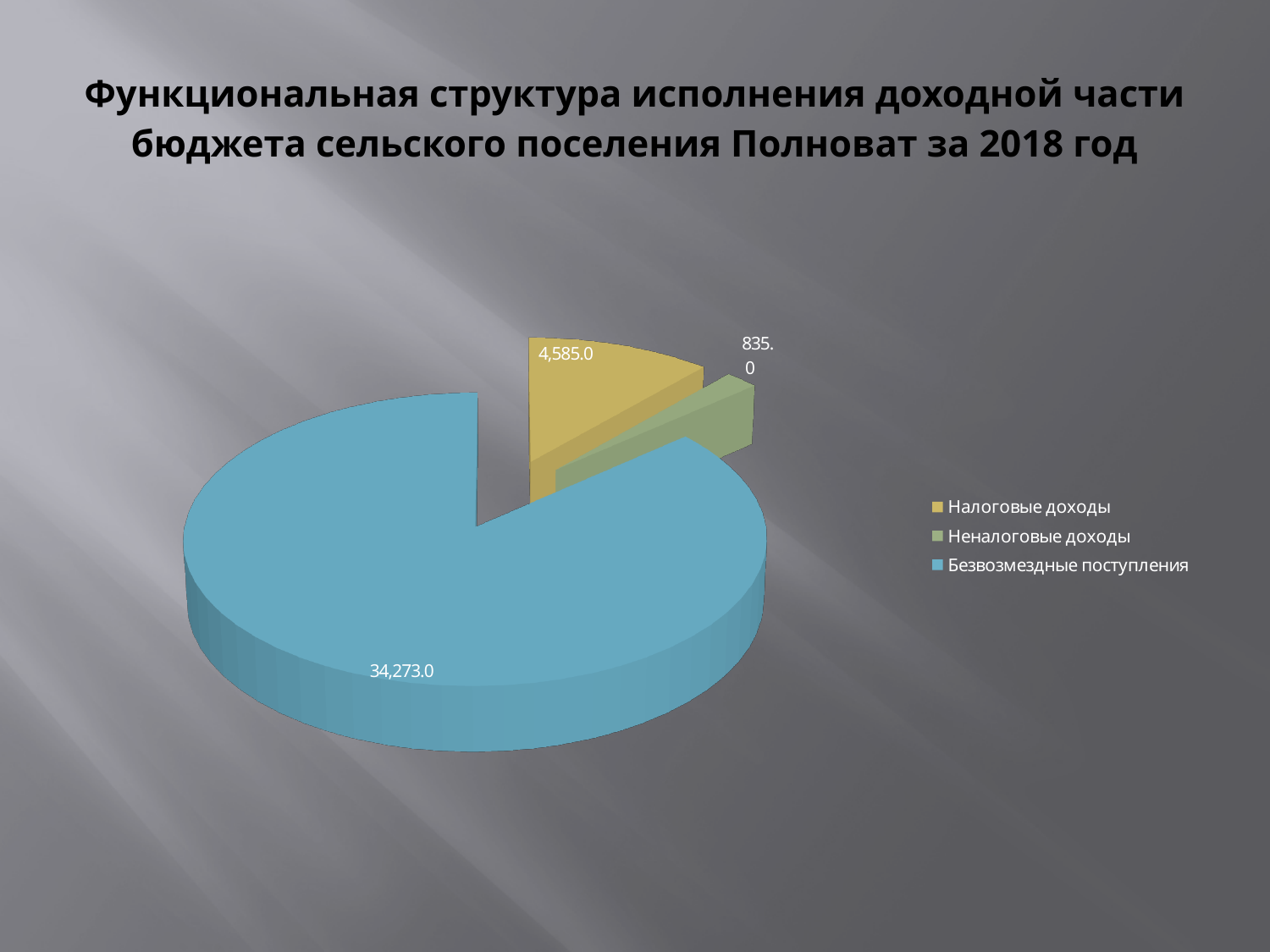
Which colour represents Безвозмездные поступления in the legend? Blue What is the difference between the values for Безвозмездные поступления and Налоговые доходы? 29,688.0 What is the total of all slices in the pie chart? 39,693.0 Which is larger, Налоговые доходы or Неналоговые доходы? Налоговые доходы What is the value for Безвозмездные поступления? 34,273.0 What is the value for Налоговые доходы? 4,585.0 What is the value for Неналоговые доходы? 835.0 What is the difference between the values for Налоговые доходы and Неналоговые доходы? 3,750.0 Which category has the largest slice of the pie? Безвозмездные поступления How many categories does the pie chart have? 3 What type of chart is shown on the slide? Pie chart Which category has the smallest slice of the pie? Неналоговые доходы